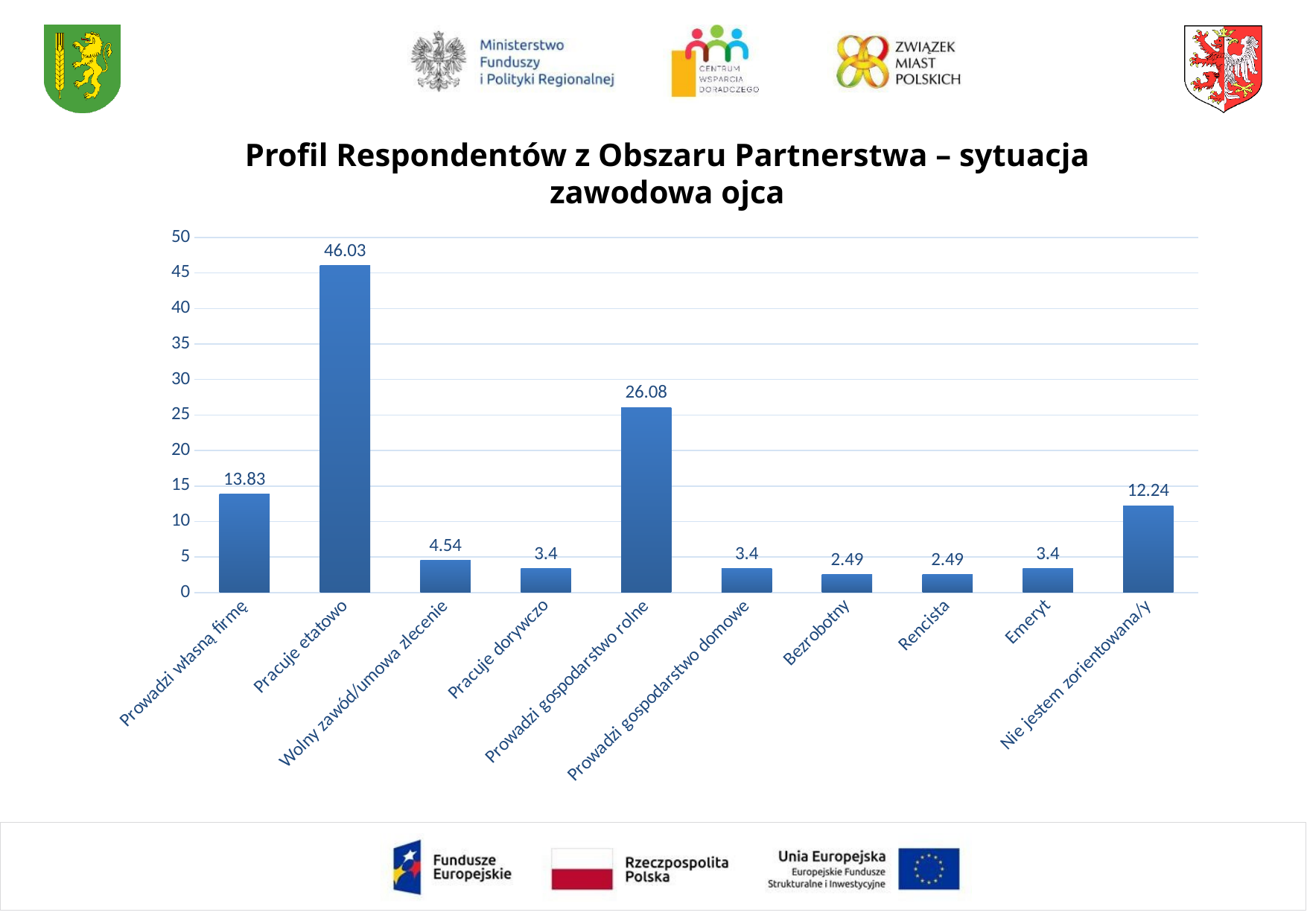
What is the value for "Pracuje etatowo"? 46.03 Which category has the highest value? Pracuje etatowo What is the value for "Nie jestem zorientowana/y"? 12.24 How many categories are shown on the x axis? 10 Which is larger, the value for "Prowadzi własną firmę" or the value for "Nie jestem zorientowana/y"? Prowadzi własną firmę What is the value for "Bezrobotny"? 2.49 What is the title of the chart? Profil Respondentów z Obszaru Partnerstwa – sytuacja zawodowa ojca What is the difference between the values for "Pracuje etatowo" and "Prowadzi gospodarstwo rolne"? 19.95 What is the value for "Wolny zawód/umowa zlecenie"? 4.54 What is the value for "Prowadzi gospodarstwo rolne"? 26.08 What is the difference between the values for "Prowadzi własną firmę" and "Nie jestem zorientowana/y"? 1.59 What kind of chart is shown on the slide? Bar chart